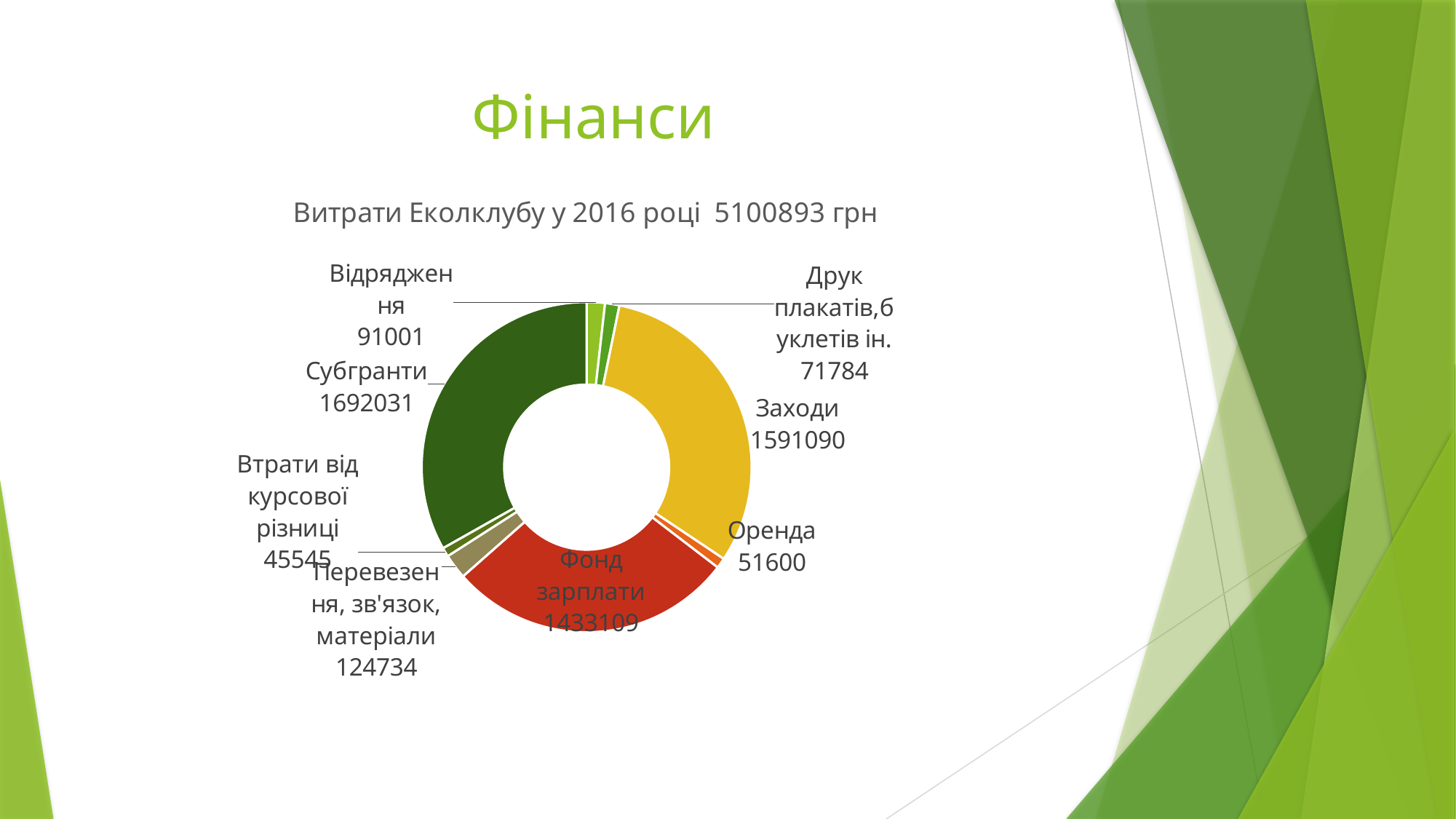
Which category has the lowest value? Втрати від курсової різниці Which category has the highest value? Субгранти What is the value for Перевезення, зв'язок, матеріали? 124734 What is the title of the chart? Витрати Еколклубу у 2016 році 5100893 грн What is the value for Оренда? 51600 What is the difference between the values for Заходи and Фонд зарплати? 157981 What is the value for Фонд зарплати? 1433109 How many categories does the chart show? 8 What type of chart is shown on the slide? doughnut chart Which is larger, the value for Відрядження or the value for Друк плакатів,буклетів ін.? Відрядження What is the difference between the values for Субгранти and Заходи? 100941 What is the value for Субгранти? 1692031